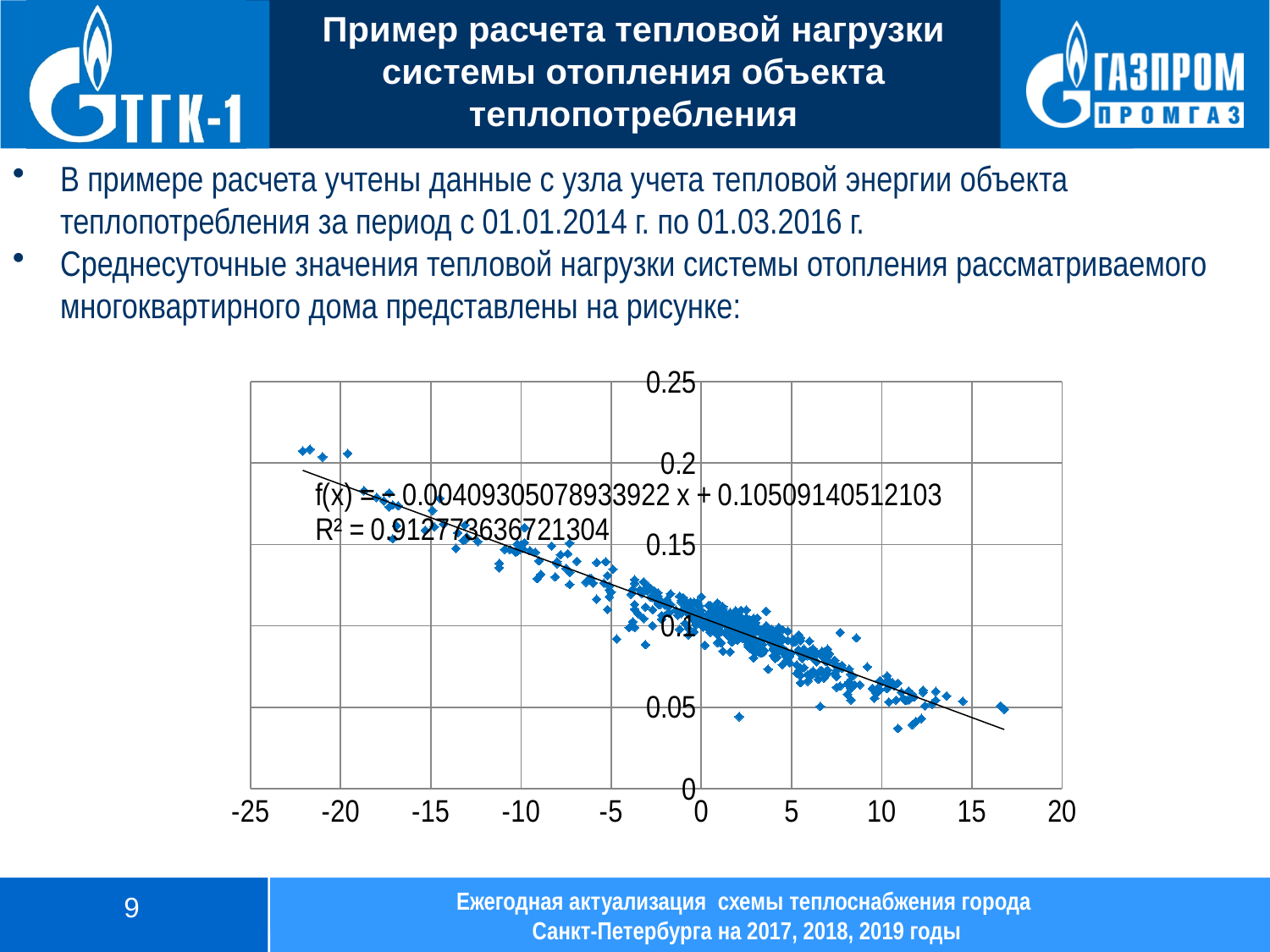
Are the plotted values near x = 10 greater or less than 0.1? less Are the plotted values near x = -20 greater or less than 0.15? greater What is the R² value printed on the chart? R² = 0.912773636721304 Which has higher plotted values: the points near x = -20 or the points near x = 15? the points near x = -20 Do the plotted values rise or fall as the x-axis value increases? fall Are the plotted values near x = 15 greater or less than 0.1? less What trendline equation is printed on the chart? f(x) = -0.00409305078933922 x + 0.10509140512103 What kind of chart is shown on the slide? scatter chart